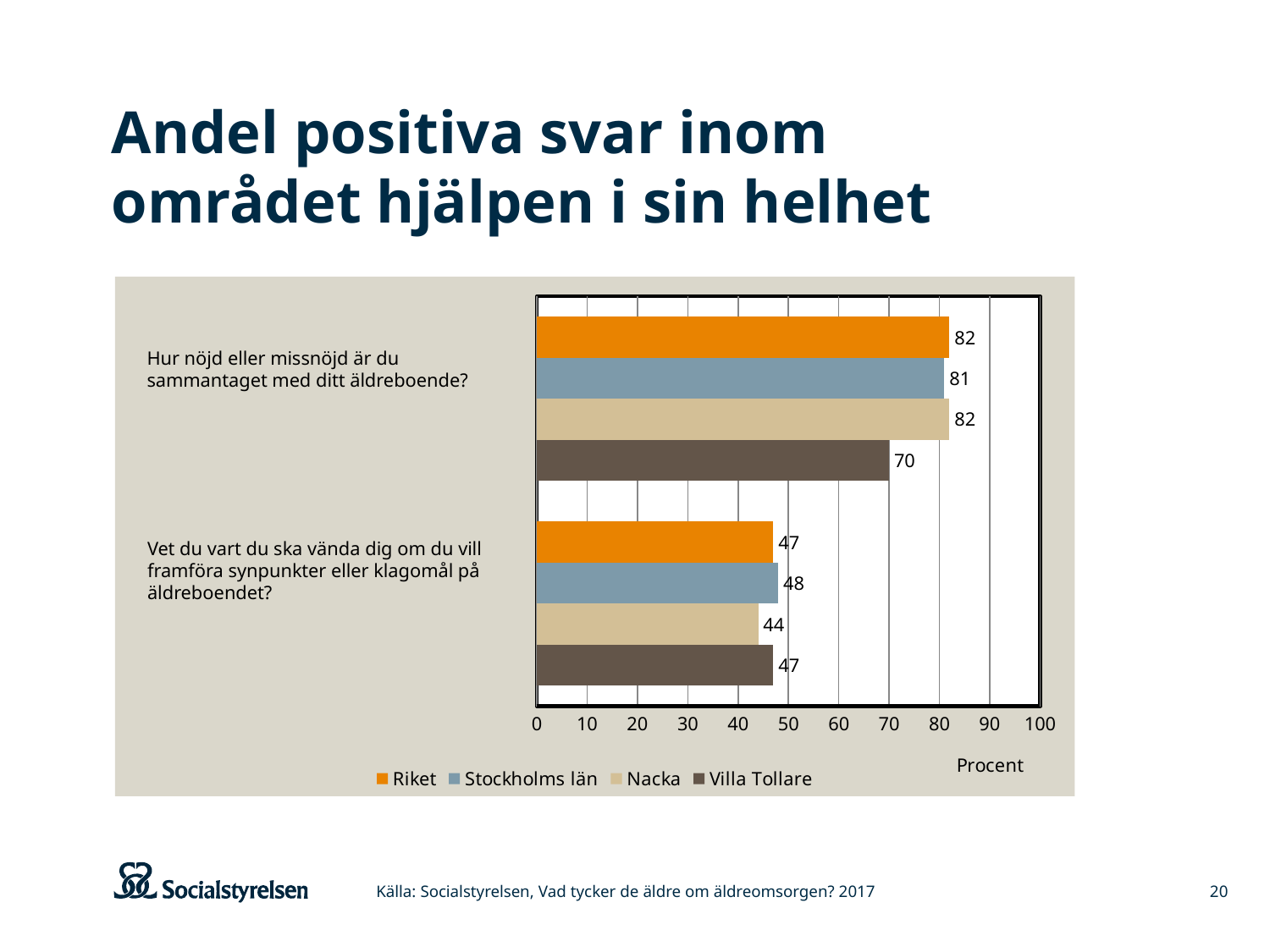
What value is shown for Nacka on the question "Vet du vart du ska vända dig om du vill framföra synpunkter eller klagomål på äldreboendet?"? 44 How many series does the legend list? 4 What value is shown for Riket on the question "Vet du vart du ska vända dig om du vill framföra synpunkter eller klagomål på äldreboendet?"? 47 How many question categories are shown on the chart? 2 What unit label is shown on the horizontal axis of the chart? Procent Which series has the lowest value on the question "Hur nöjd eller missnöjd är du sammantaget med ditt äldreboende?"? Villa Tollare What is the difference between the Riket value and the Villa Tollare value on the question "Hur nöjd eller missnöjd är du sammantaget med ditt äldreboende?"? 12 What value is shown for Stockholms län on the question "Hur nöjd eller missnöjd är du sammantaget med ditt äldreboende?"? 81 Which is larger on the question "Vet du vart du ska vända dig om du vill framföra synpunkter eller klagomål på äldreboendet?": the value for Stockholms län or the value for Nacka? Stockholms län What value is shown for Villa Tollare on the question "Hur nöjd eller missnöjd är du sammantaget med ditt äldreboende?"? 70 Which series has the highest value on the question "Vet du vart du ska vända dig om du vill framföra synpunkter eller klagomål på äldreboendet?"? Stockholms län What kind of chart is shown on the slide? Bar chart